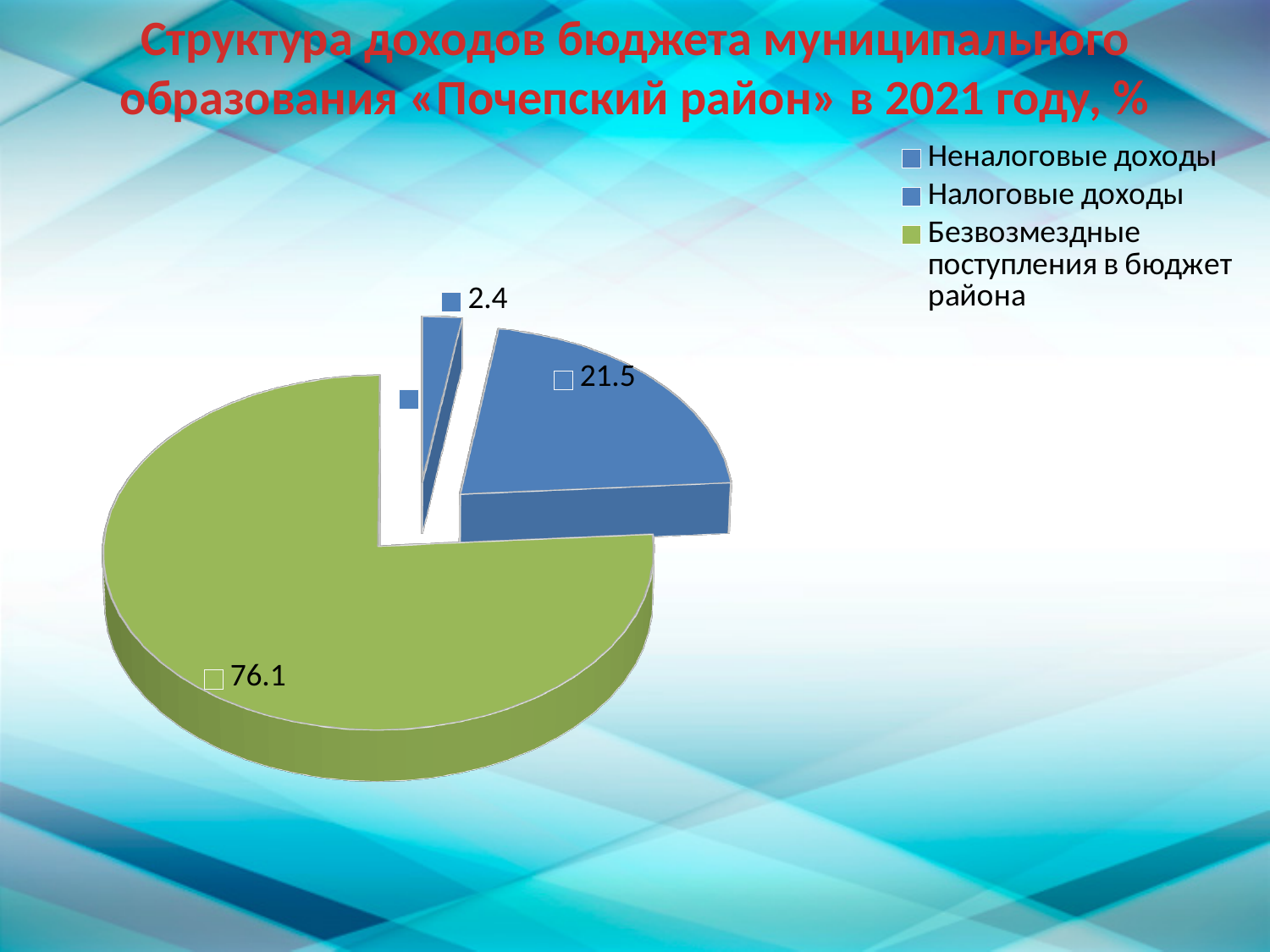
What is the value for Безвозмездные поступления в бюджет района? 76.1 What colour is the slice for Безвозмездные поступления в бюджет района? green What is the value for Неналоговые доходы? 2.4 What is the difference between the values for Безвозмездные поступления в бюджет района and Налоговые доходы? 54.6 Which category has the smallest share of the pie? Неналоговые доходы What is the value for Налоговые доходы? 21.5 What kind of chart is shown on the slide? pie chart Which is larger, Налоговые доходы or Неналоговые доходы? Налоговые доходы What is the difference between the values for Налоговые доходы and Неналоговые доходы? 19.1 How many entries does the legend list? 3 Which category has the largest share of the pie? Безвозмездные поступления в бюджет района How many slices does the pie chart have? 3